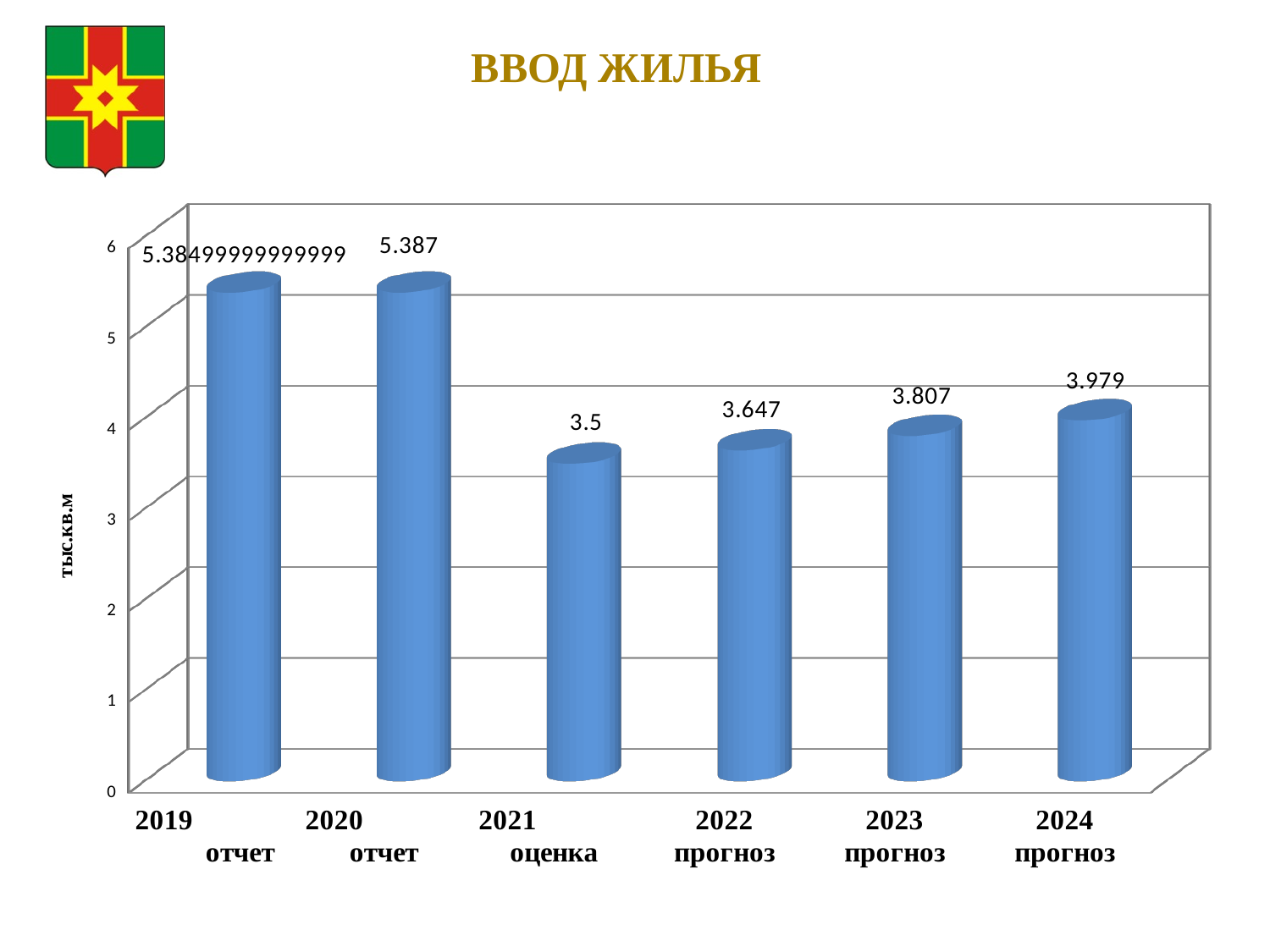
What is the difference between the values for 2023 and 2022? 0.16 What is the value for 2020 (отчет)? 5.387 What is the value for 2021 (оценка)? 3.5 What is the difference between the values for 2024 and 2021? 0.479 What kind of chart is shown on the slide? bar chart How many years are shown on the chart? 6 Which is larger, the value for 2023 or the value for 2022? 2023 Which year has the lowest value? 2021 What is the value for 2024 (прогноз)? 3.979 Is the value for 2022 greater or less than 4? less Do the values rise or fall from 2021 to 2024? rise What is the value for 2022 (прогноз)? 3.647